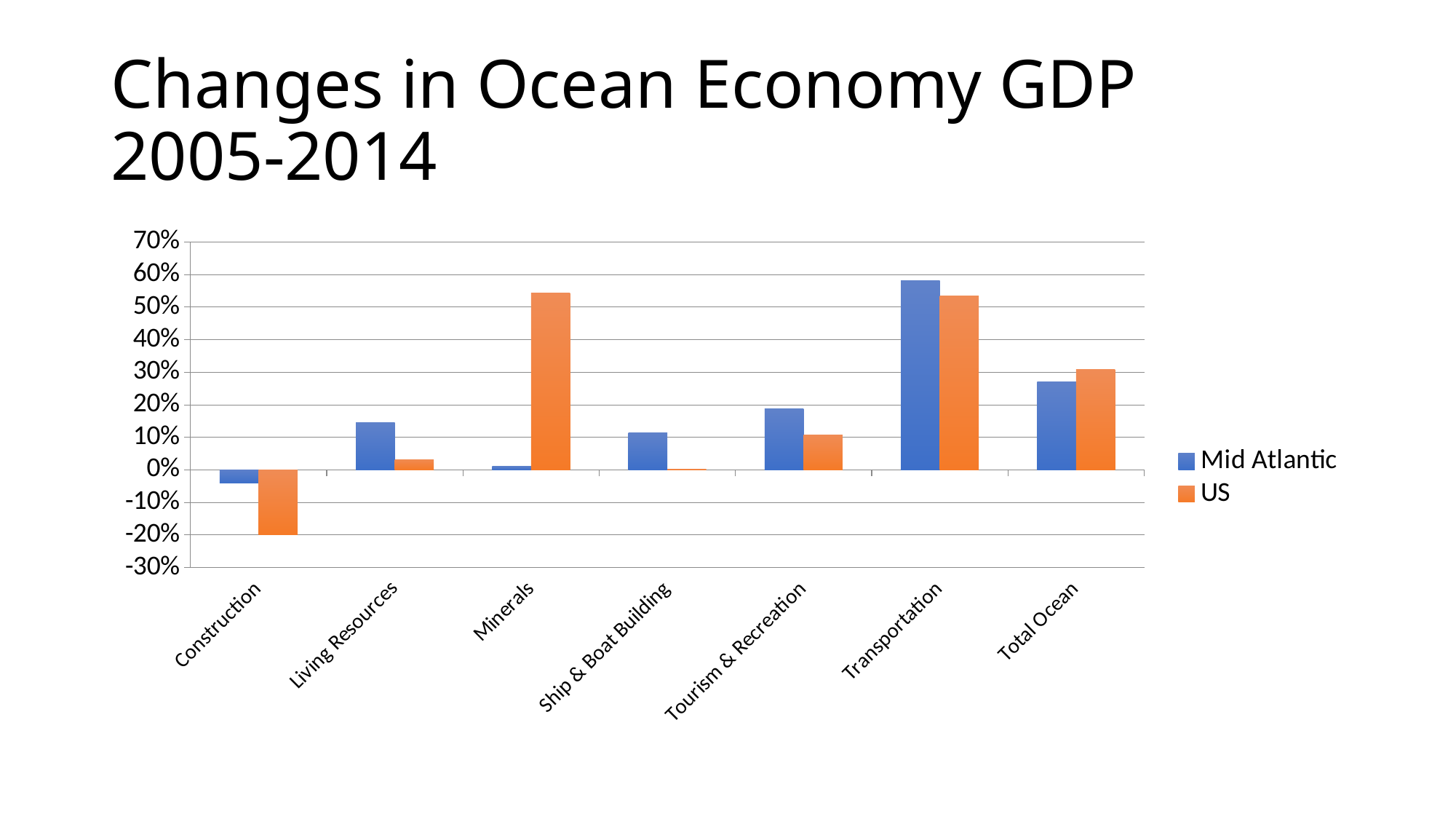
Which category has the lowest US value? Construction What colour represents the US series in the legend? orange Which category has the highest Mid Atlantic value? Transportation For Total Ocean, which series has the larger value, Mid Atlantic or US? US Is the Mid Atlantic value for Tourism & Recreation greater or less than 10%? greater Is the US value for Construction greater or less than -10%? less How many series does the legend list? 2 Which category has the highest US value? Minerals Is the US value for Minerals greater or less than 50%? greater What kind of chart is shown on the slide? bar chart For Transportation, which series has the larger value, Mid Atlantic or US? Mid Atlantic How many sector categories are shown along the x axis? 7